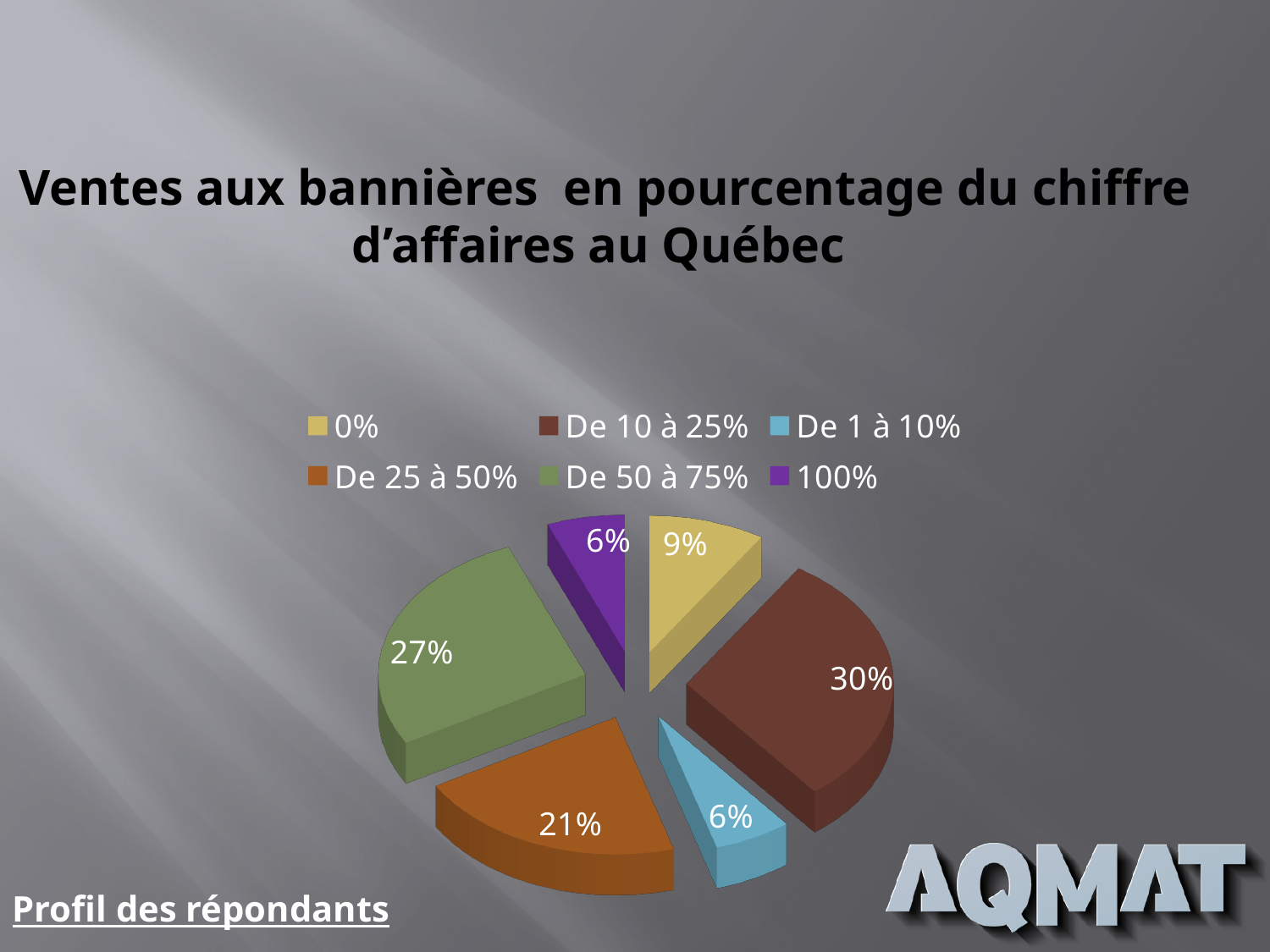
What kind of chart is shown on the slide? Pie chart What share of the pie does the "100%" slice represent? 6% What is the title of the chart? Ventes aux bannières en pourcentage du chiffre d'affaires au Québec What share of the pie does the "De 10 à 25%" slice represent? 30% What is the difference between the "De 10 à 25%" slice and the "De 25 à 50%" slice? 9% How many slices does the pie chart have? 6 What share of the pie does the "De 50 à 75%" slice represent? 27% What share of the pie does the "De 25 à 50%" slice represent? 21% What colour is the "De 1 à 10%" slice in the pie chart? Blue Which category has the largest slice of the pie? De 10 à 25% What share of the pie does the "0%" slice represent? 9% Which is larger, the "De 50 à 75%" slice or the "0%" slice? De 50 à 75%